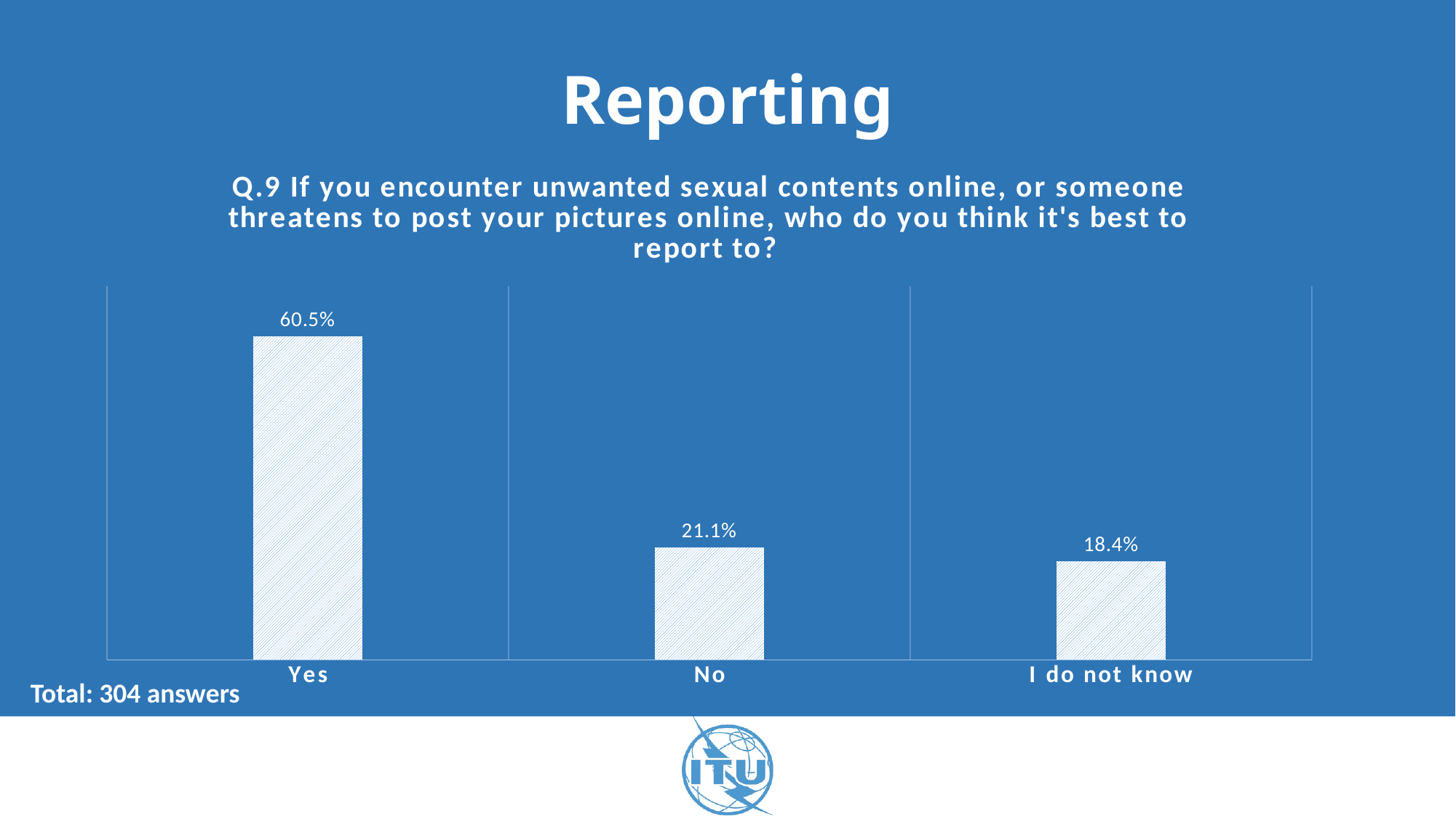
What kind of chart is shown on the slide? Bar chart What is the value for "I do not know"? 18.4% How many categories are shown on the x axis? 3 What is the value for "No"? 21.1% How many total answers does the slide say the chart is based on? 304 answers Which category has the highest value? Yes What is the value for "Yes"? 60.5% What is the difference between the values for "Yes" and "No"? 39.4% Which category has the lowest value? I do not know What is the difference between the values for "No" and "I do not know"? 2.7% Which is larger, the value for "Yes" or the value for "I do not know"? Yes Do the values rise or fall from left to right along the x axis? Fall